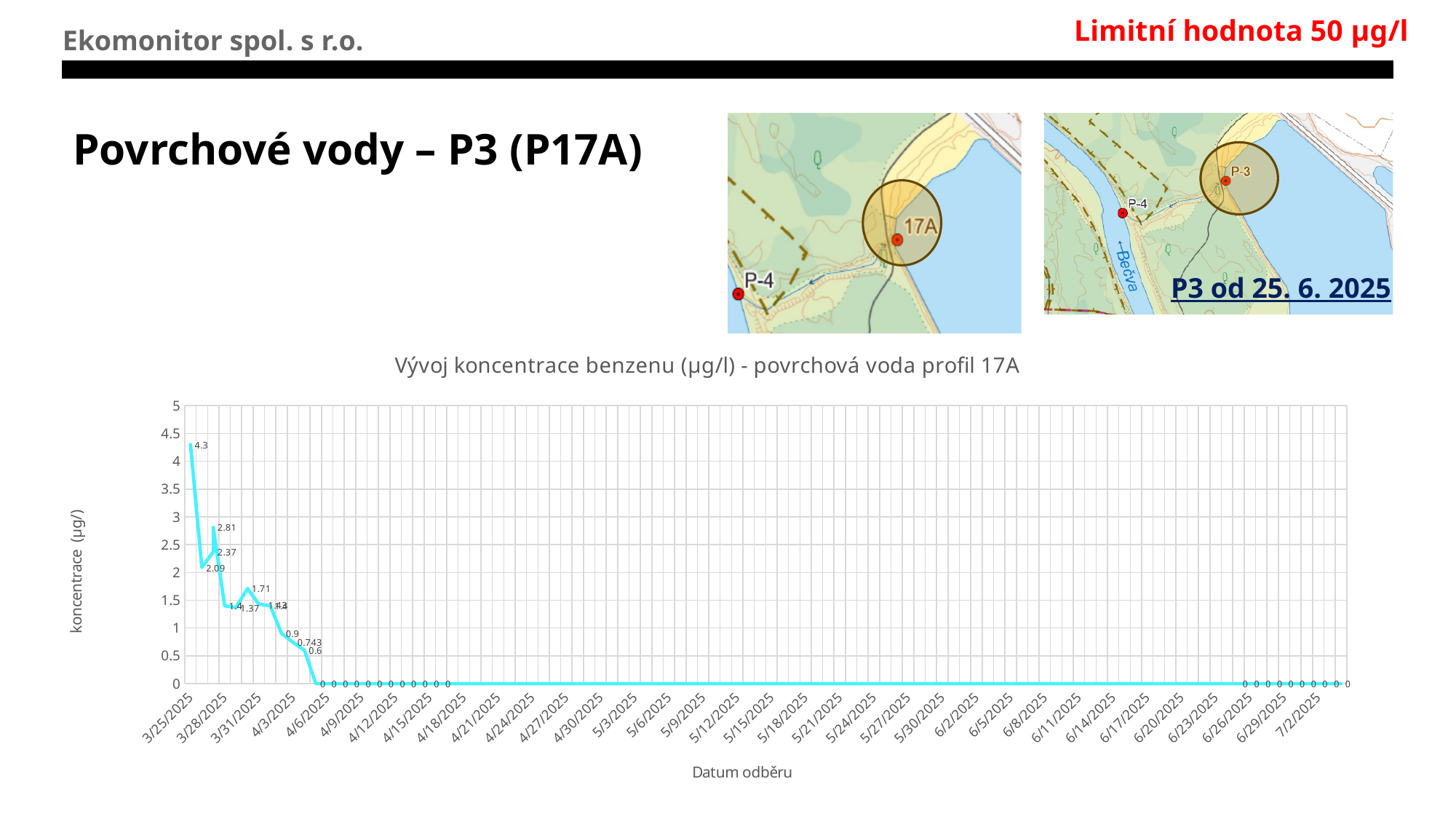
What is the value plotted for 6/29/2025? 0 Is the highest value on the chart greater or less than 5? less What is the highest value plotted on the chart? 4.3 Is the value for 3/25/2025 greater or less than 4? greater What is the label of the vertical axis of the chart? koncentrace (µg/l) What is the title of the chart? Vývoj koncentrace benzenu (µg/l) - povrchová voda profil 17A What kind of chart is shown on the slide? line chart What is the benzene concentration value plotted for 3/25/2025? 4.3 What is the difference between the first value (4.3) and the value labeled 2.81? 1.49 What is the lowest value plotted on the chart? 0 What is the value plotted for 4/6/2025? 0 Do the values generally rise or fall along the x axis from 3/25/2025 onward? fall